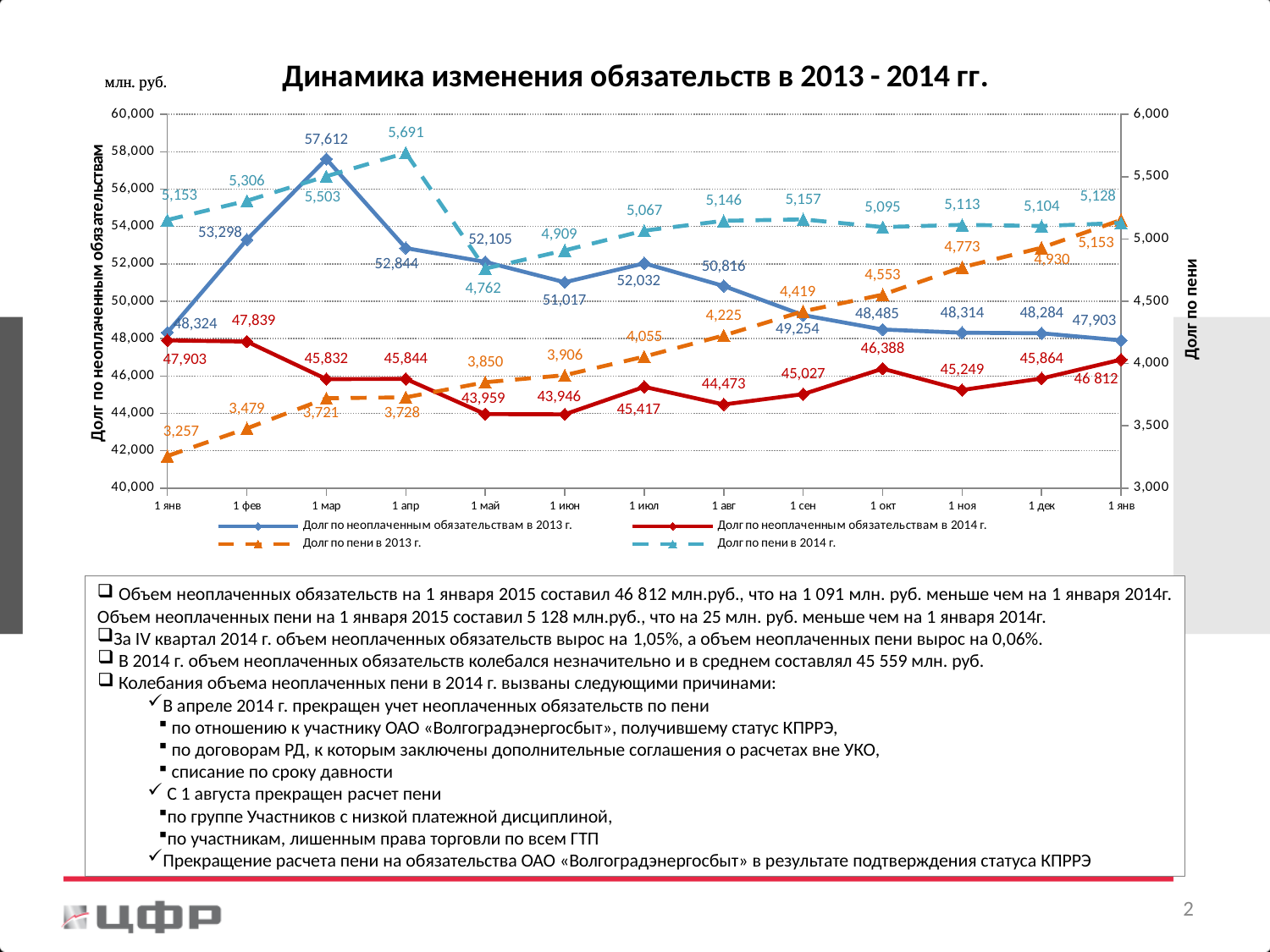
For 'Долг по неоплаченным обязательствам в 2014 г.', which is larger: the value at 1 июл or at 1 авг? 1 июл How many points are plotted along the x axis for each series? 13 At which date does 'Долг по неоплаченным обязательствам в 2013 г.' reach its highest value? 1 мар Does 'Долг по пени в 2013 г.' rise or fall along the x axis? rise At which date is 'Долг по пени в 2013 г.' at its lowest? 1 янв What is the value of 'Долг по неоплаченным обязательствам в 2014 г.' at 1 окт? 46,388 What kind of chart is shown on the slide? line chart What is the value of 'Долг по пени в 2014 г.' at 1 апр? 5,691 What is the title of the chart? Динамика изменения обязательств в 2013 - 2014 гг. What is the difference between the 1 мар and 1 апр values of 'Долг по неоплаченным обязательствам в 2013 г.'? 4,768 How many series does the legend list? 4 What is the value of 'Долг по неоплаченным обязательствам в 2013 г.' at 1 мар? 57,612